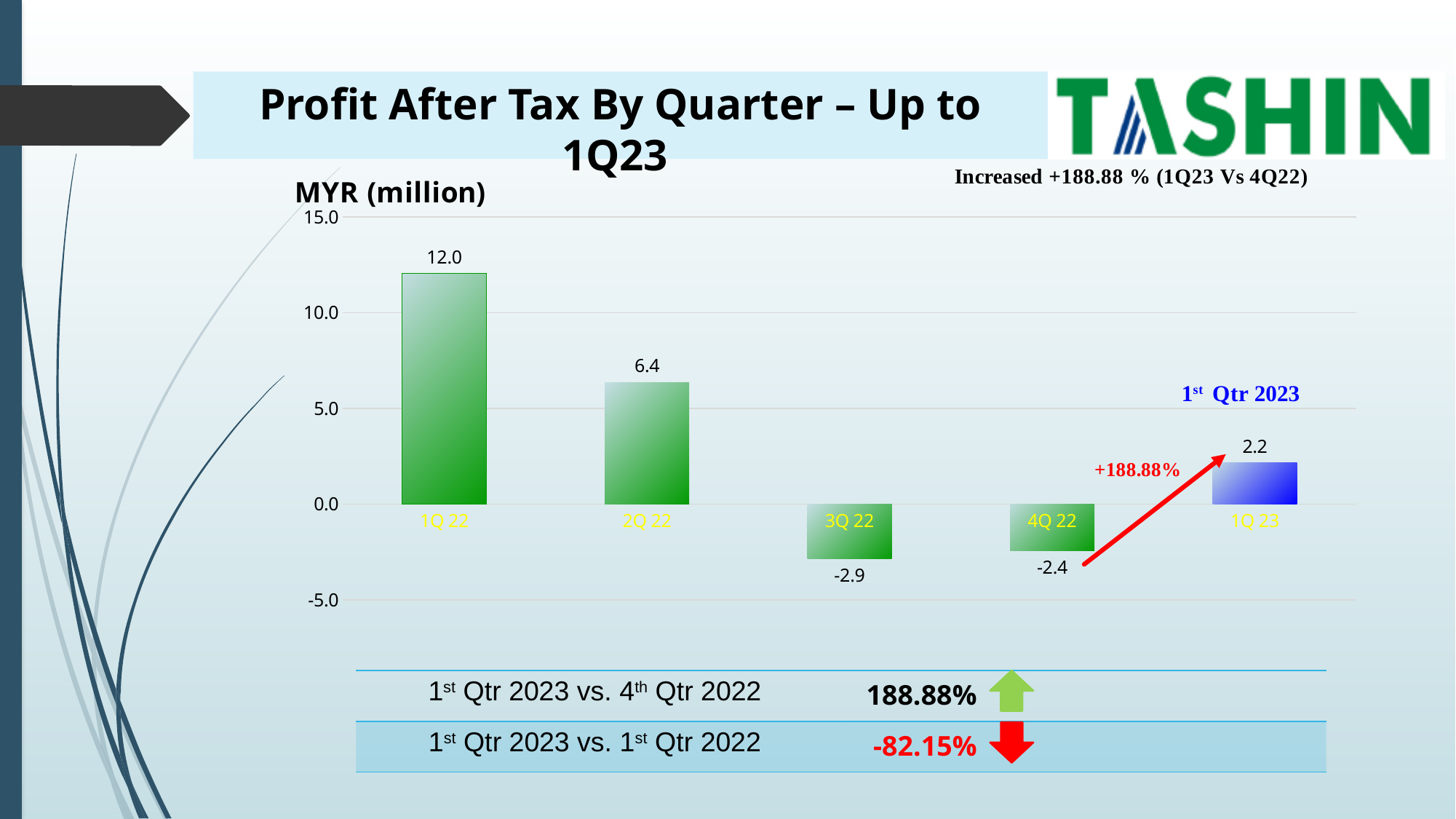
Which is larger, the profit after tax for 2Q 22 or 1Q 23? 2Q 22 What percentage change is shown between 4Q 22 and 1Q 23 on the chart? +188.88% What is the profit after tax for 1Q 22? 12.0 What unit is shown on the chart's axis label? MYR (million) Which quarter has the lowest profit after tax? 3Q 22 Is the value for 2Q 22 greater or less than 5.0? greater What is the difference between the profit after tax for 1Q 22 and 2Q 22? 5.6 How many quarters are shown in the chart? 5 Which quarter has the highest profit after tax? 1Q 22 What is the profit after tax for 3Q 22? -2.9 What is the profit after tax for 1Q 23? 2.2 What kind of chart is shown on the slide? bar chart